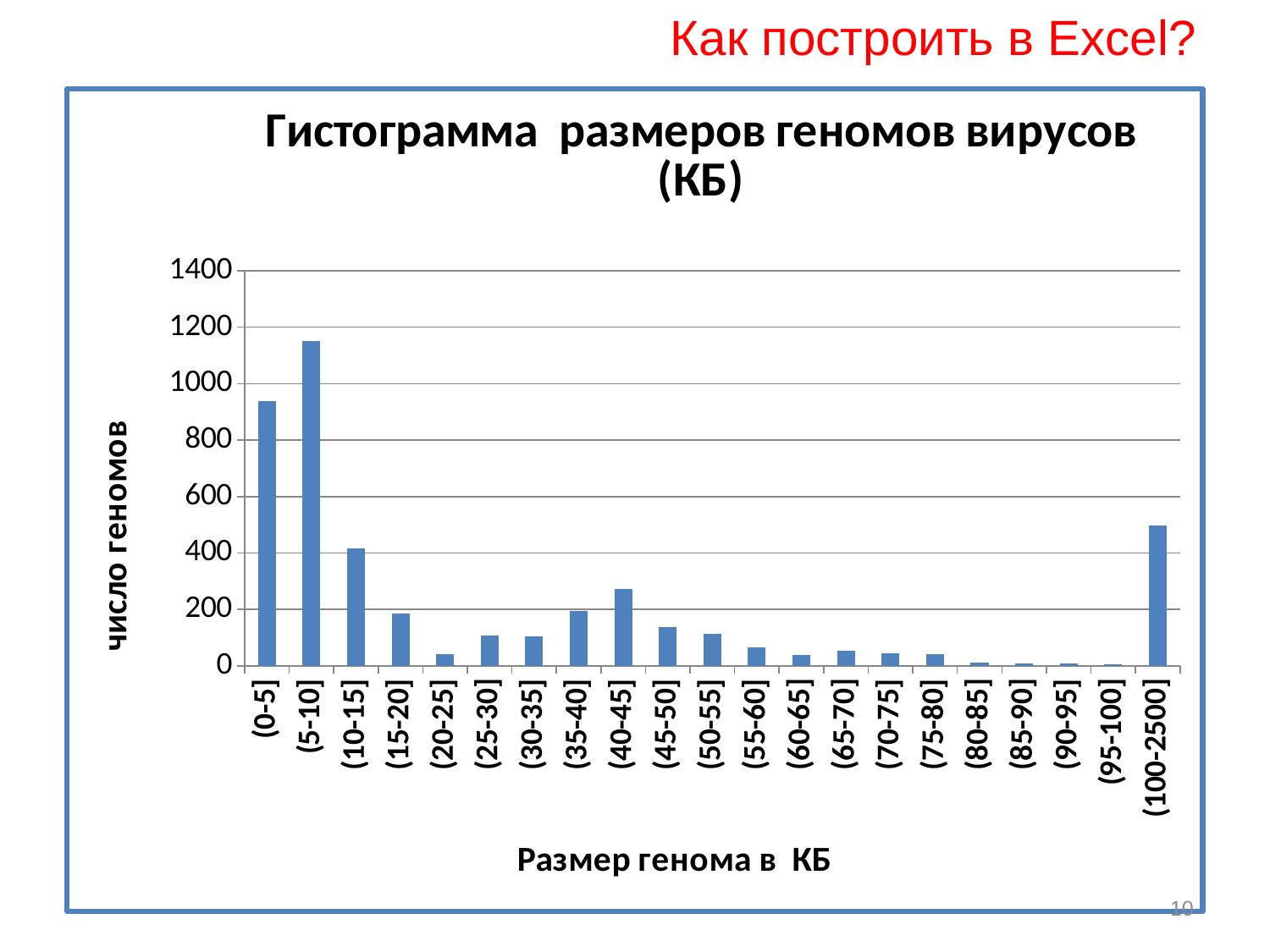
Which bin has more genomes, (40-45] or (35-40]? (40-45] Which bin has more genomes, (0-5] or (100-2500]? (0-5] What is the title of the chart? Гистограмма размеров геномов вирусов (КБ) What is the label of the vertical axis? число геномов Which genome size bin has the highest number of genomes? (5-10] Is the value for the (100-2500] bin greater or less than 600? less Is the value for the (40-45] bin greater or less than 200? greater What kind of chart is shown on the slide? Bar chart Is the value for the (5-10] bin greater or less than 1000? greater How many genome size bins are shown on the x axis? 21